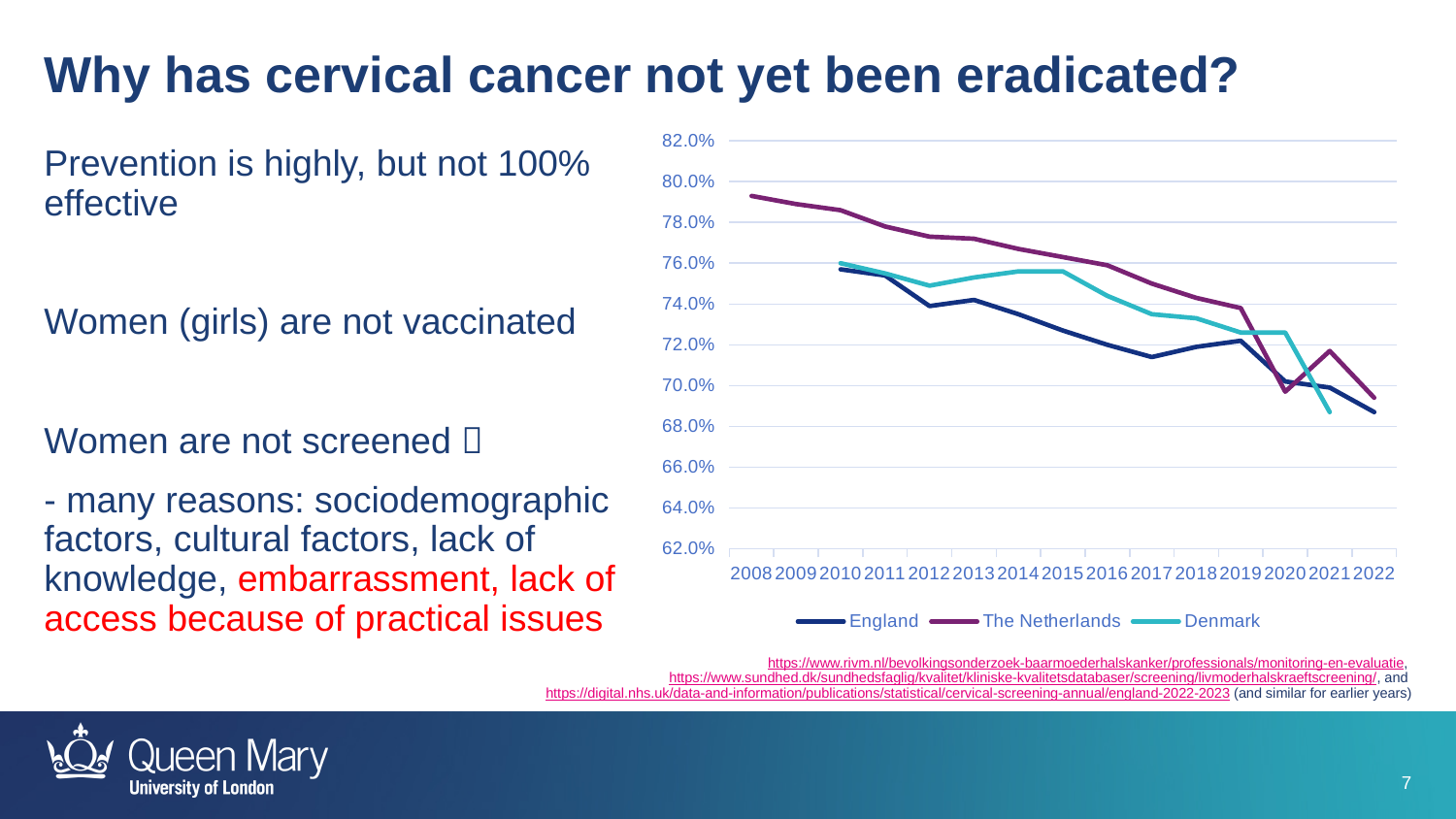
In 2017, which is higher: Denmark or England? Denmark In 2012, which is higher: England or The Netherlands? The Netherlands In 2021, which is higher: Denmark or The Netherlands? The Netherlands Which series in the chart has data starting in 2008? The Netherlands How many years are labelled on the x axis of the chart? 15 How many series does the chart's legend list? 3 Is the value for Denmark in 2014 greater or less than 74.0%? greater Does the line for The Netherlands generally rise or fall from 2008 to 2022? fall Is the value for England in 2022 greater or less than 70.0%? less Which three countries are listed in the chart's legend? England, The Netherlands, Denmark Is the value for The Netherlands in 2008 greater or less than 78.0%? greater What kind of chart is shown on the slide? line chart